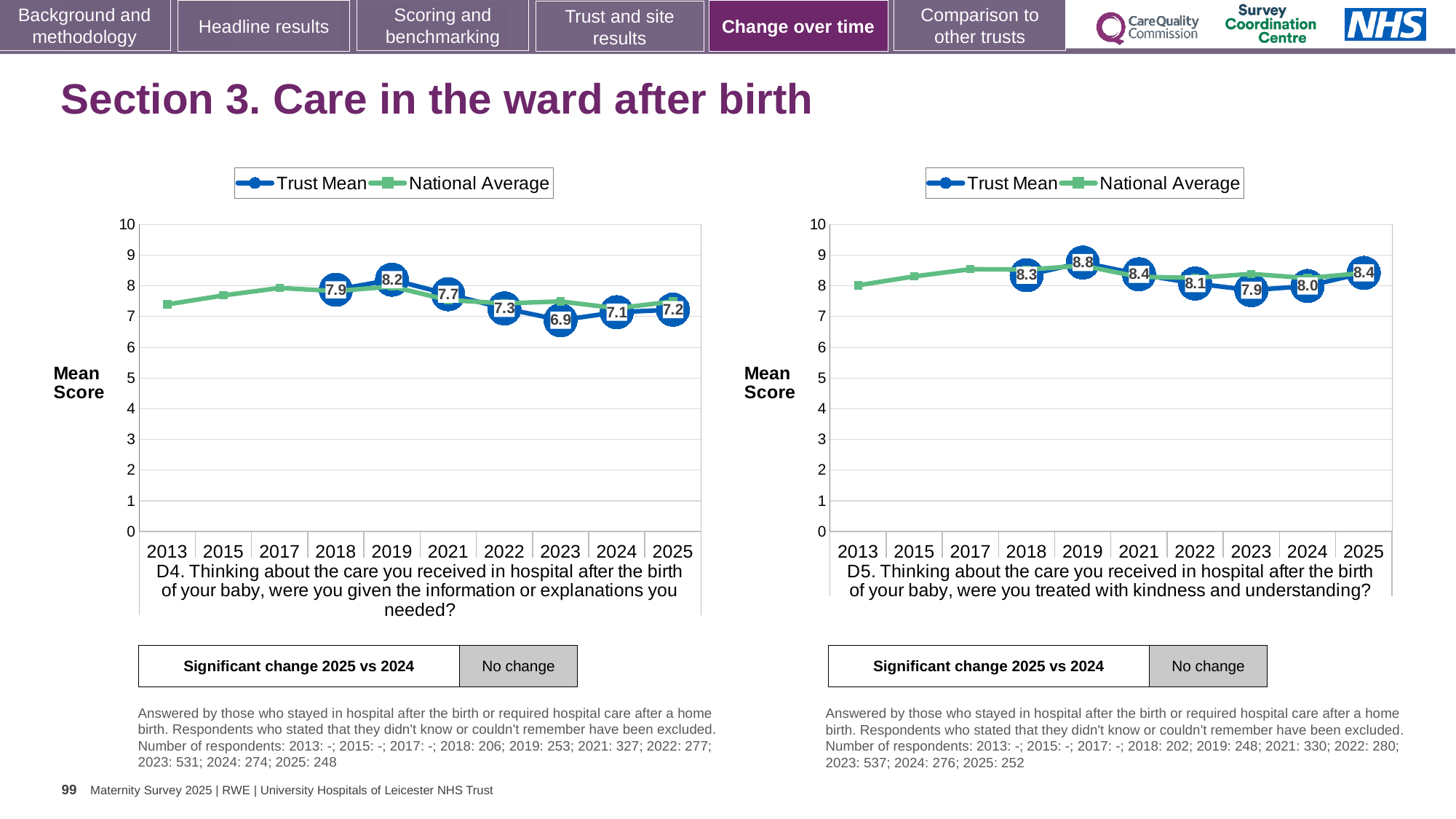
In the left chart (D4), what is the Trust Mean for 2023? 6.9 In the left chart (D4), is the National Average for 2013 greater or less than 8? less How many series does the legend of the left chart (D4) list? 2 How many years are shown on the x axis of the right chart (D5)? 10 In the left chart (D4), which year has the lowest Trust Mean? 2023 What kind of chart is the right chart (D5)? line chart In the left chart (D4), does the Trust Mean rise or fall from 2019 to 2023? fall In the right chart (D5), which year has the highest Trust Mean? 2019 In the left chart (D4), what is the Trust Mean for 2019? 8.2 In the left chart (D4), what is the difference between the Trust Mean in 2019 and in 2023? 1.3 In the right chart (D5), which is larger, the Trust Mean for 2018 or for 2022? 2018 In the right chart (D5), what is the Trust Mean for 2025? 8.4